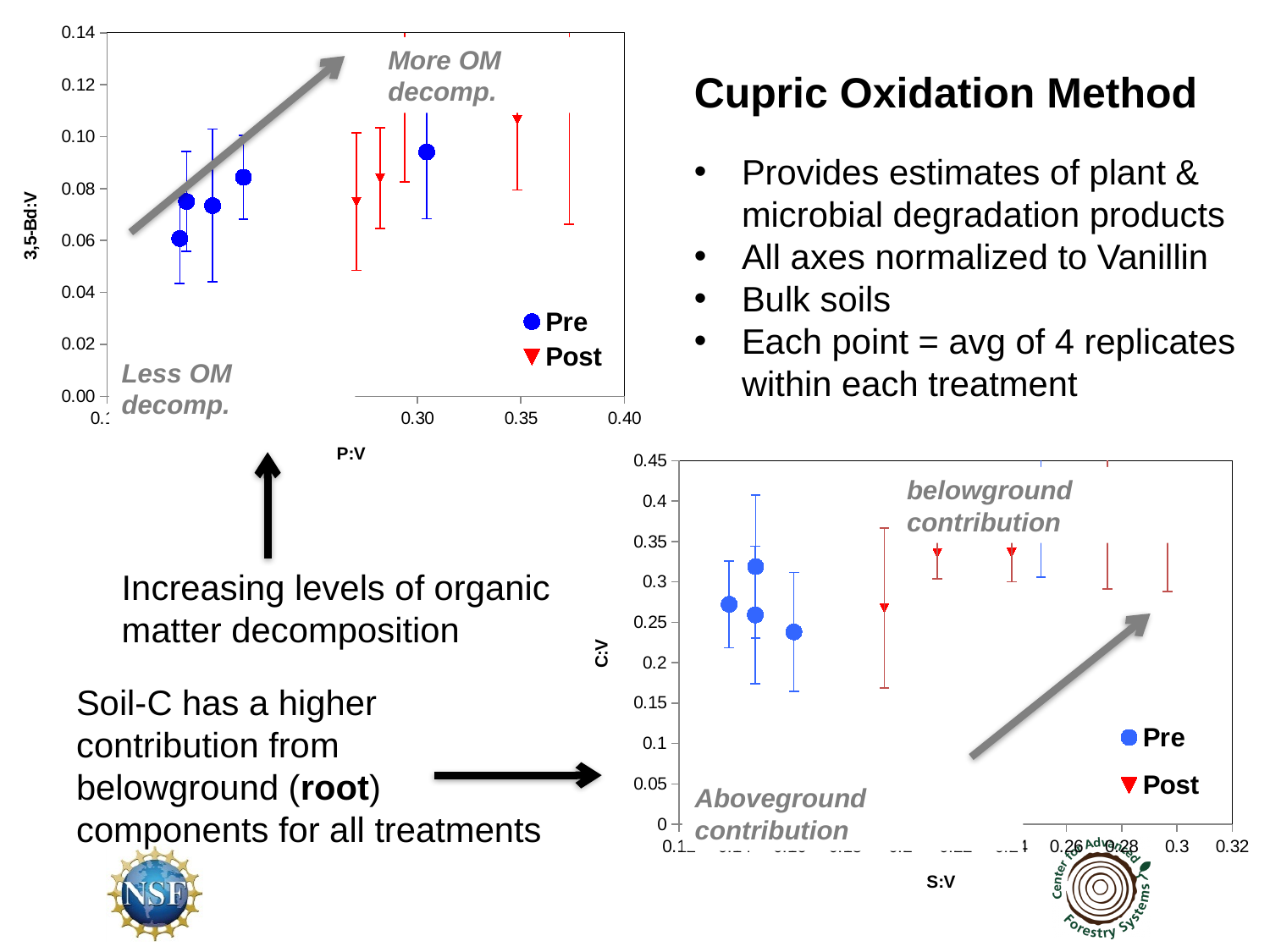
In the bottom-right chart, which marker shape and colour represents the Post series? red triangle What kind of chart is the bottom-right chart (C:V vs S:V)? scatter chart How many series does the legend of the bottom-right chart list? 2 What kind of chart is the top-left chart (3,5-Bd:V vs P:V)? scatter chart In the top-left chart, what are the two series named in the legend? Pre and Post How many series does the legend of the top-left chart list? 2 In the top-left chart, is the lowest Pre point's 3,5-Bd:V value greater or less than 0.04? greater In the top-left chart, do the Pre points' 3,5-Bd:V values rise or fall as P:V increases? rise In the bottom-right chart, is the lowest Pre point's C:V value greater or less than 0.2? greater In the top-left chart, how many Pre (blue circle) points are plotted? 5